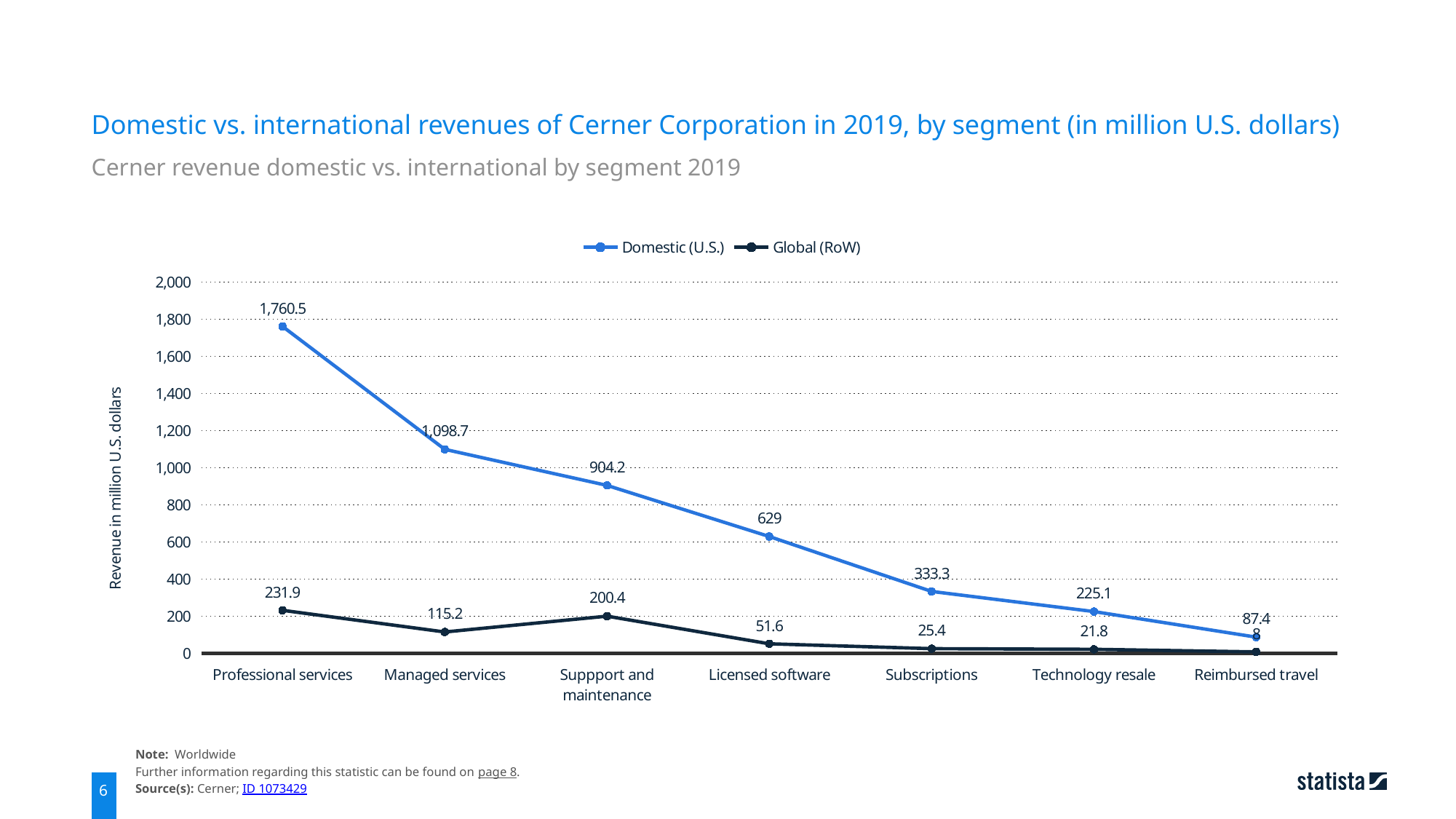
How many segments are shown on the x axis? 7 What is the Global (RoW) revenue for Reimbursed travel? 8 What is the difference between the Domestic (U.S.) and Global (RoW) revenue for Managed services? 983.5 Which is larger: the Global (RoW) revenue for Subscriptions or for Technology resale? Subscriptions What kind of chart is shown on the slide? Line chart Does the Domestic (U.S.) series rise or fall from Professional services to Reimbursed travel? Fall Which segment has the highest Domestic (U.S.) revenue? Professional services What is the Domestic (U.S.) revenue for Professional services? 1,760.5 What is the Global (RoW) revenue for Support and maintenance? 200.4 How many series does the legend list? 2 Which segment has the lowest Global (RoW) revenue? Reimbursed travel What is the Domestic (U.S.) revenue for Licensed software? 629